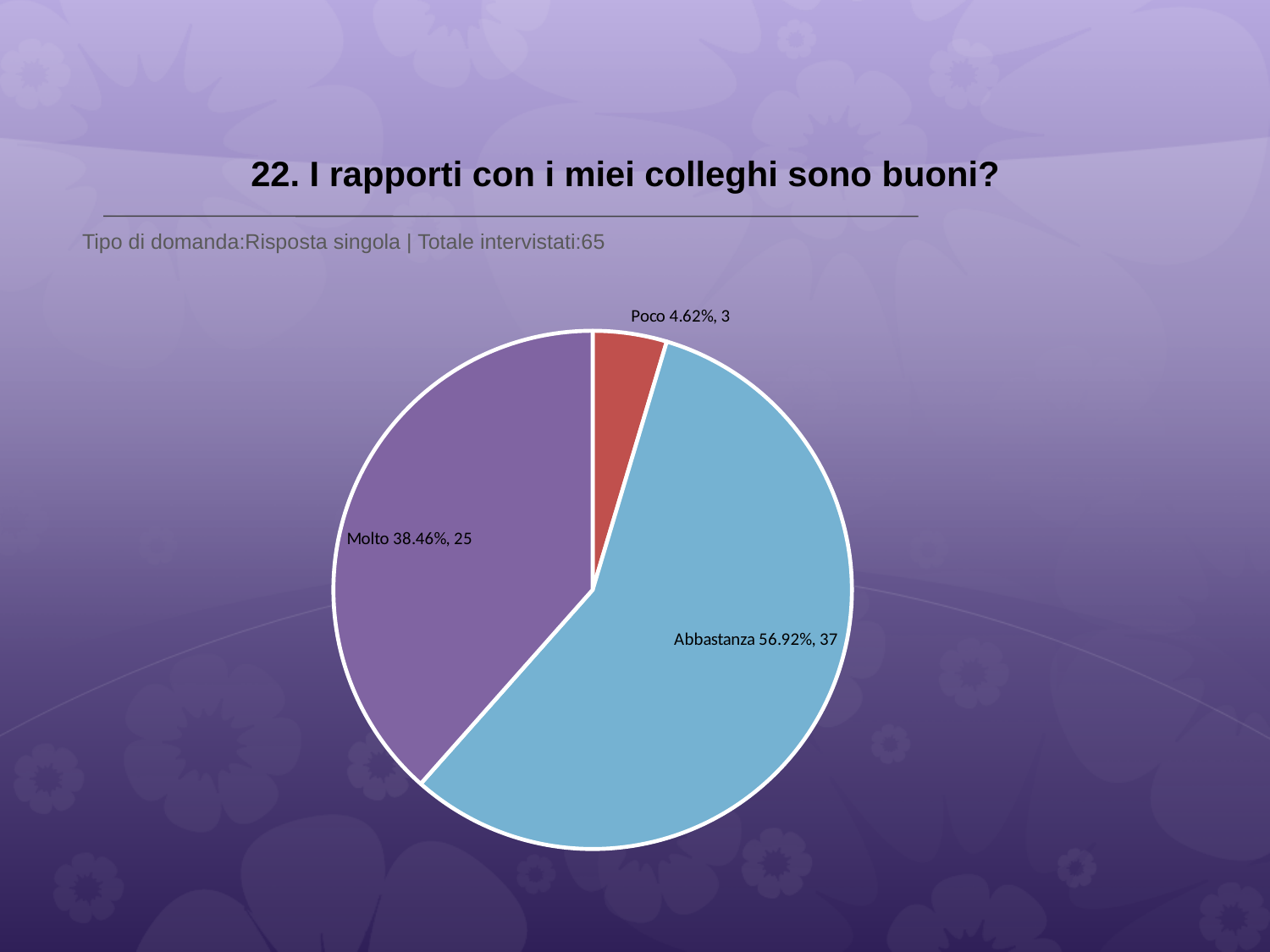
How many respondents answered Poco? 3 Which category has the smallest slice? Poco Which is larger, the Molto slice or the Poco slice? Molto What percentage share does the Molto slice have? 38.46% Which category has the largest slice? Abbastanza What percentage share does the Poco slice have? 4.62% What kind of chart is shown on the slide? pie chart What percentage share does the Abbastanza slice have? 56.92% What is the difference in respondent count between Abbastanza and Molto? 12 How many slices does the pie chart have? 3 How many respondents answered Molto? 25 How many respondents answered Abbastanza? 37